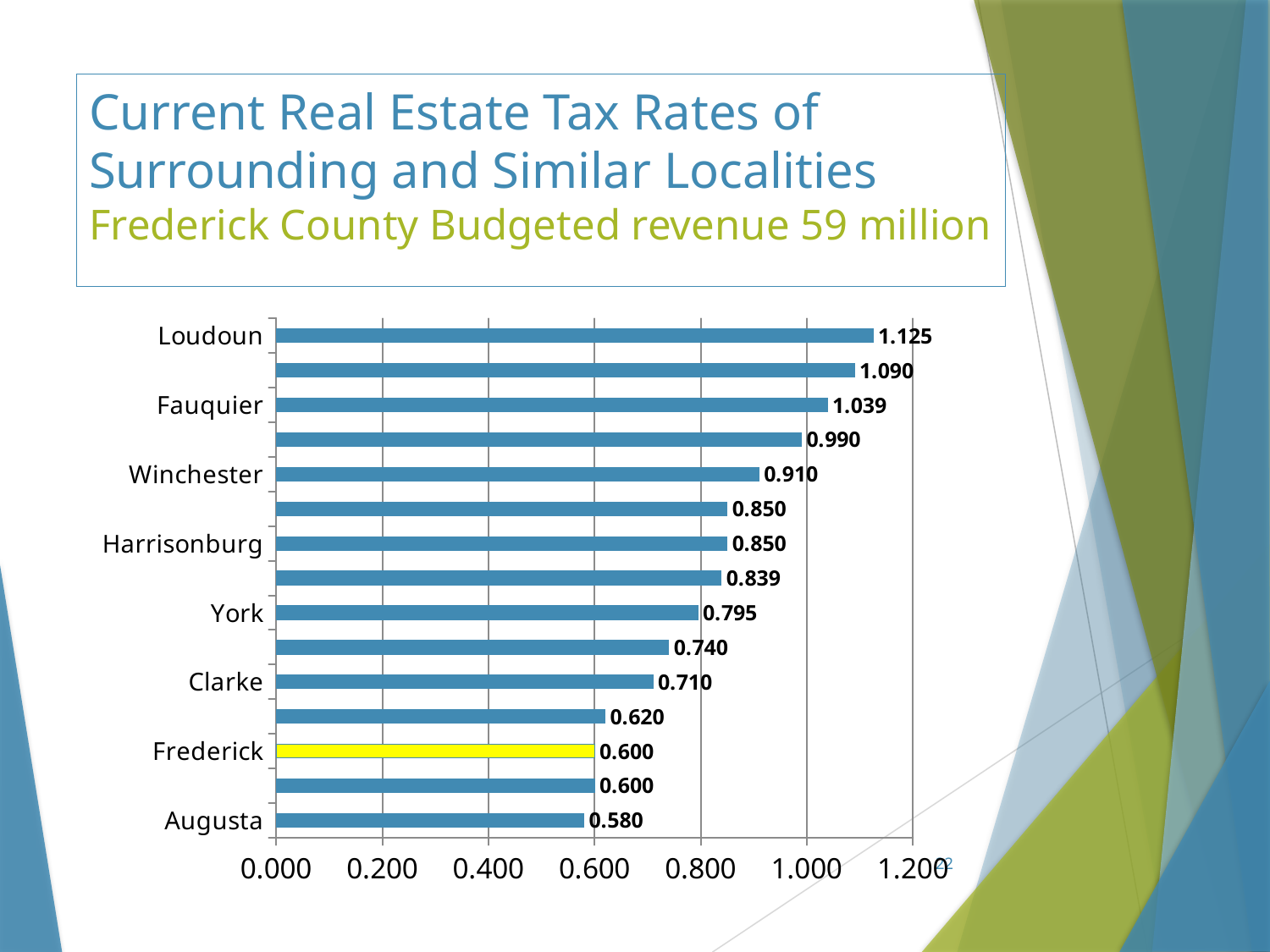
What is the value shown for Augusta? 0.580 Which has a higher value, York or Clarke? York What is the value shown for Frederick? 0.600 What is the value shown for Winchester? 0.910 How many bars are plotted in the chart? 15 What is the real estate tax rate shown for Loudoun? 1.125 Which locality's bar is highlighted in yellow? Frederick Which labeled locality has the highest tax rate? Loudoun Which labeled locality has the lowest tax rate? Augusta What type of chart is shown on the slide? Bar chart What is the difference between the values for Loudoun and Frederick? 0.525 What is the difference between the values for Fauquier and Harrisonburg? 0.189